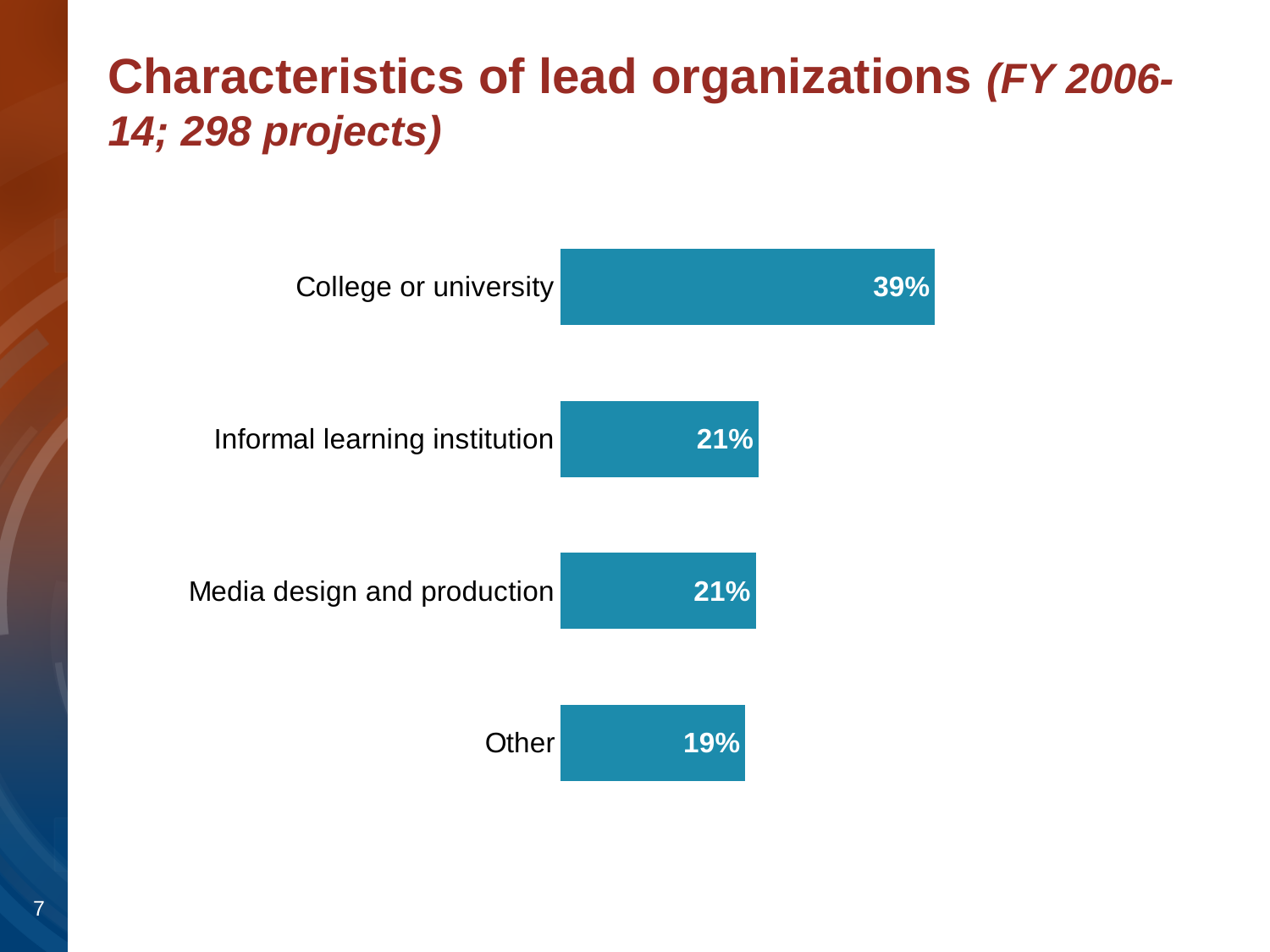
What kind of chart is shown on the slide? Bar chart What is the value for Informal learning institution? 21% What is the value for Media design and production? 21% Which category has the highest value? College or university What is the difference between the values for College or university and Informal learning institution? 18% What is the difference between the values for College or university and Other? 20% How many projects does the slide title say the data covers? 298 projects Which is larger, the value for Media design and production or the value for Other? Media design and production Which category has the lowest value? Other What percentage of lead organizations are a college or university? 39% How many categories are shown in the chart? 4 What is the value for the Other category? 19%